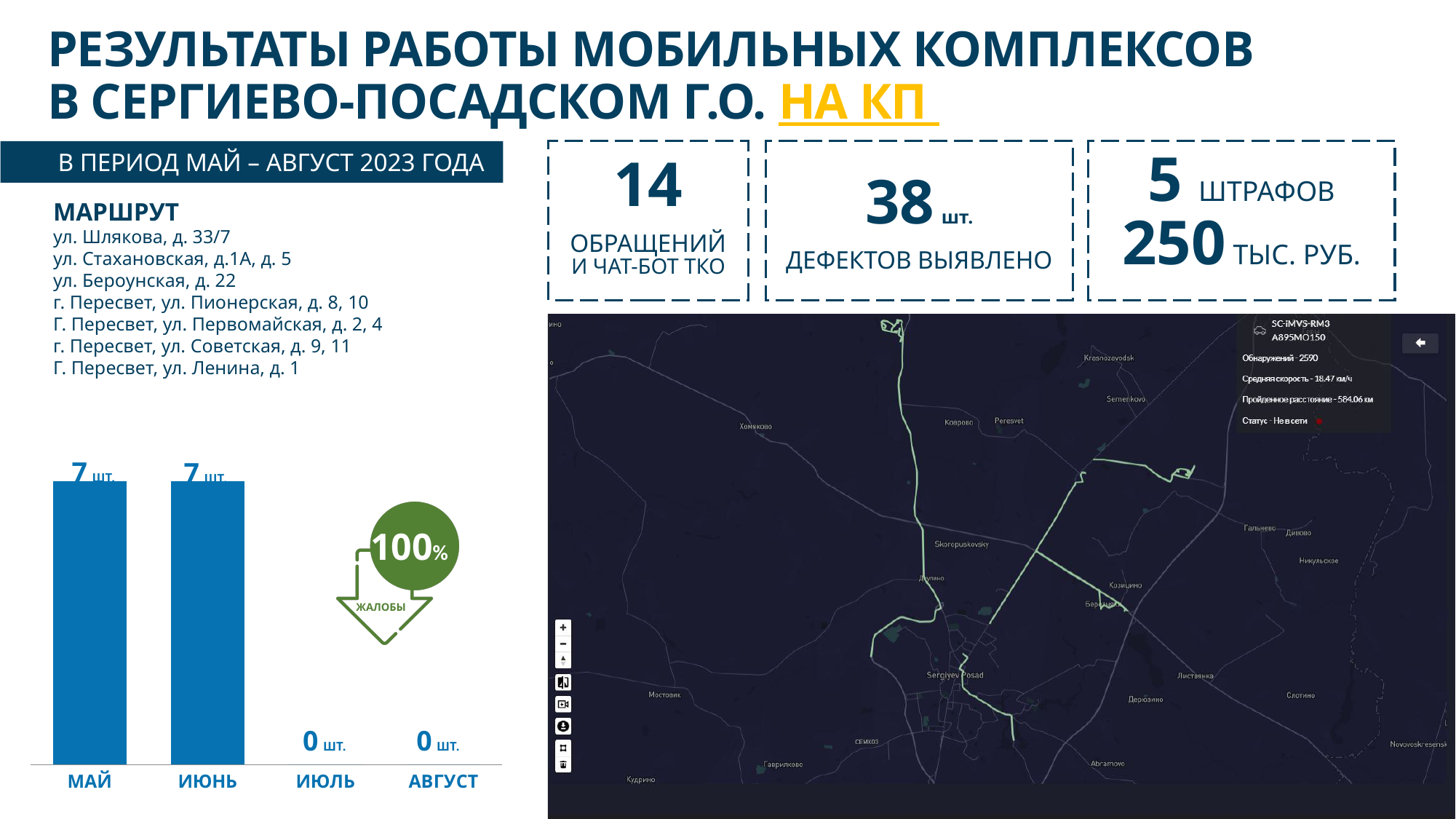
Which is larger in the bar chart, the value for МАЙ or the value for ИЮЛЬ? МАЙ What is the value for АВГУСТ in the bar chart? 0 шт. What is the difference between the values for ИЮНЬ and АВГУСТ in the bar chart? 7 шт. Which is larger in the bar chart, the value for АВГУСТ or the value for ИЮНЬ? ИЮНЬ What percentage is shown in the green circle next to the bar chart? 100% What is the value for МАЙ in the bar chart? 7 шт. Do the values in the bar chart rise or fall from МАЙ to АВГУСТ? fall How many categories (months) are shown on the x axis of the bar chart? 4 What is the value for ИЮЛЬ in the bar chart? 0 шт. What kind of chart is shown on the left of the slide? bar chart What is the value for ИЮНЬ in the bar chart? 7 шт. What is the difference between the values for МАЙ and ИЮЛЬ in the bar chart? 7 шт.